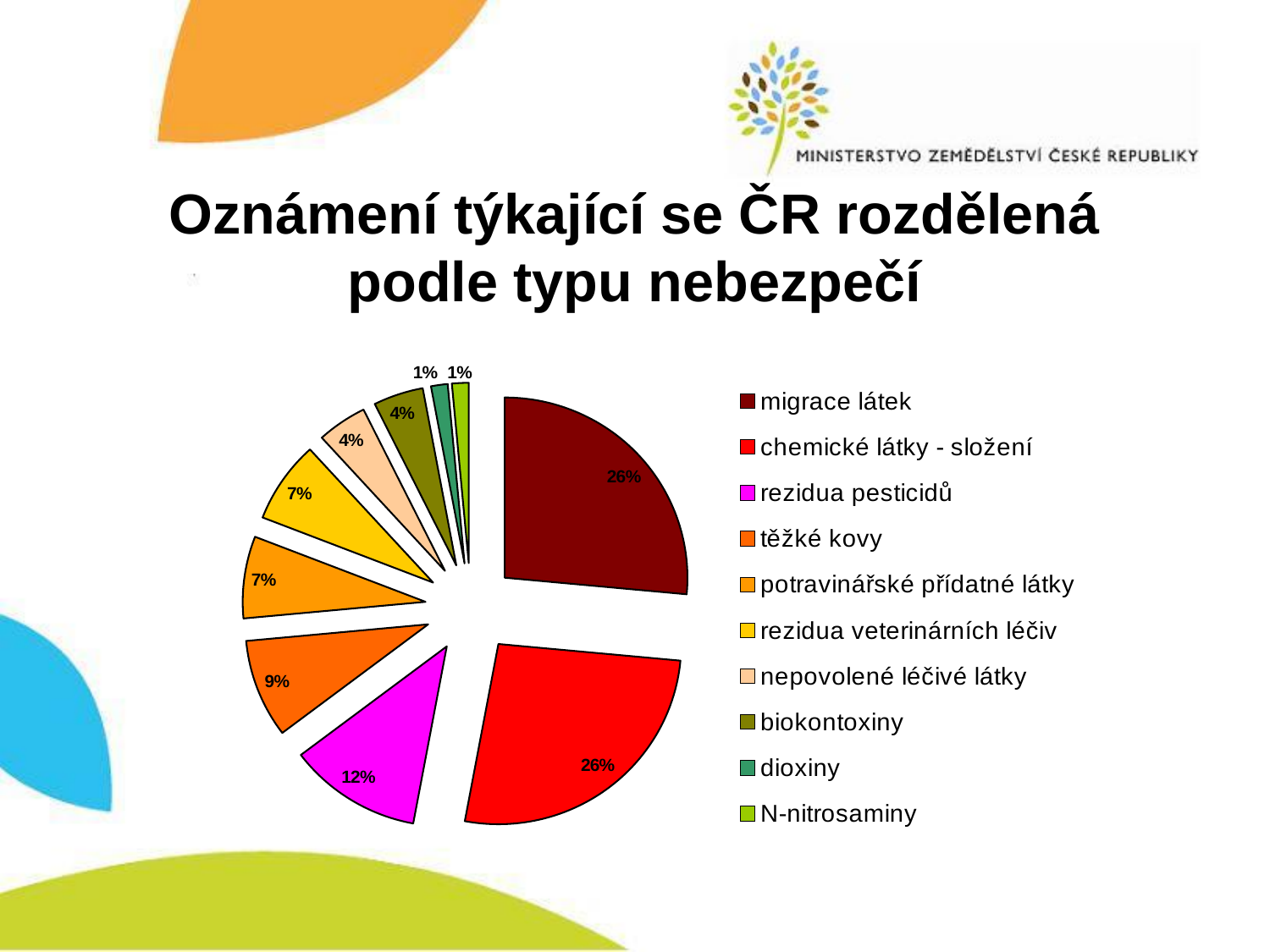
What is the value shown for "dioxiny"? 1% What is the value shown for "migrace látek"? 26% How many categories does the pie chart have? 10 What is the difference in percentage points between "rezidua pesticidů" and "těžké kovy"? 3 Which is larger, the share for "rezidua pesticidů" or the share for "těžké kovy"? rezidua pesticidů What is the value shown for "biokontoxiny"? 4% What is the title of the chart on the slide? Oznámení týkající se ČR rozdělená podle typu nebezpečí What type of chart is shown on the slide? pie chart What share of the pie does "rezidua pesticidů" represent? 12% What is the value shown for "chemické látky - složení"? 26% Which category is shown in magenta in the legend? rezidua pesticidů What is the value shown for "těžké kovy"? 9%